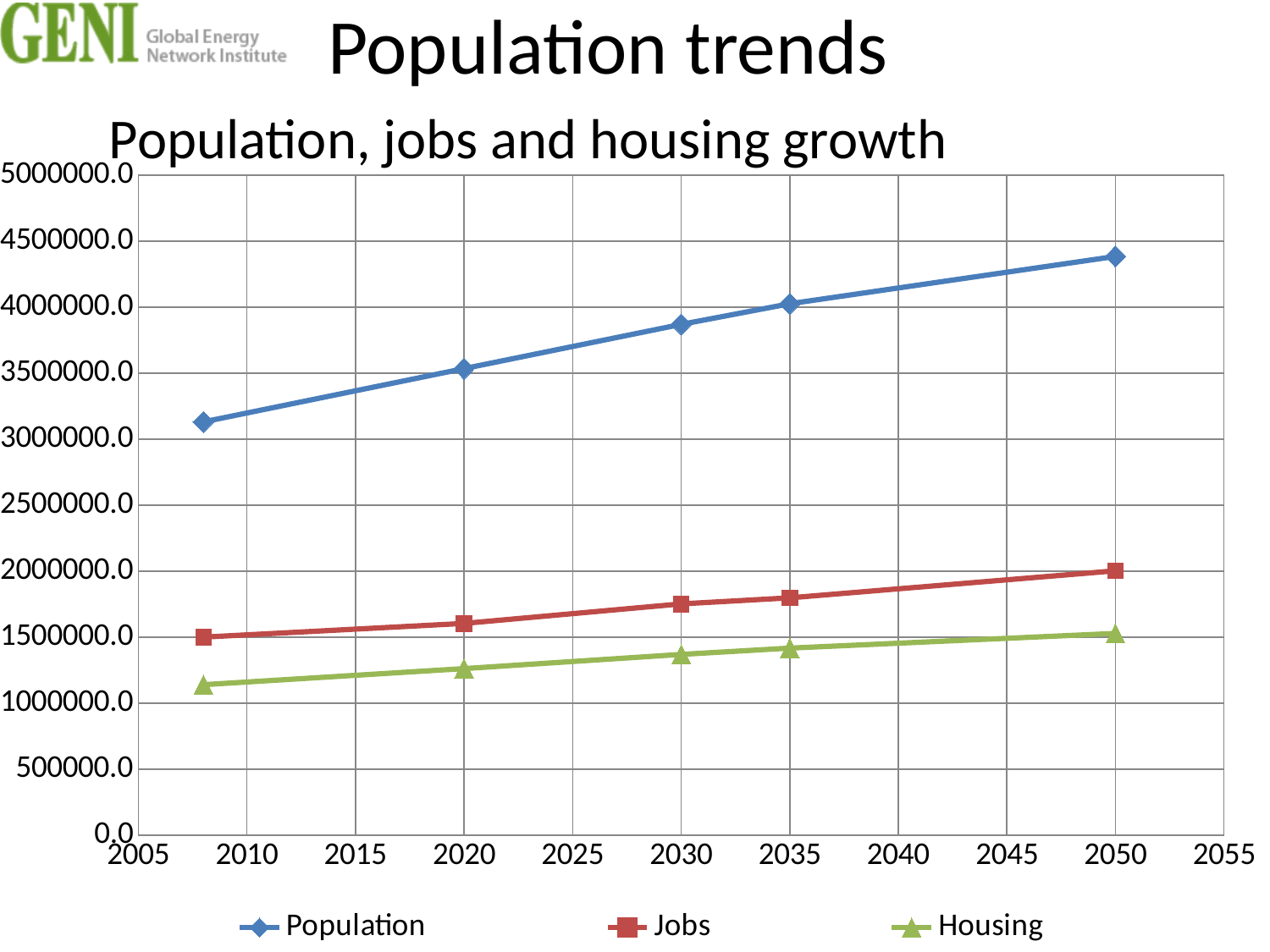
Is the Housing value for 2008 greater or less than 1500000.0? less What is the title of the chart? Population, jobs and housing growth How many series does the legend list? 3 In 2050, which is larger, the Jobs value or the Housing value? Jobs How many data points are plotted for the Population series? 5 Do the Population values rise or fall from 2008 to 2050? rise Which series has the highest values across all years? Population What kind of chart is shown on the slide? line chart Is the Population value for 2030 greater or less than 4000000.0? less Which series has the lowest values across all years? Housing Is the Population value for 2050 greater or less than 4000000.0? greater